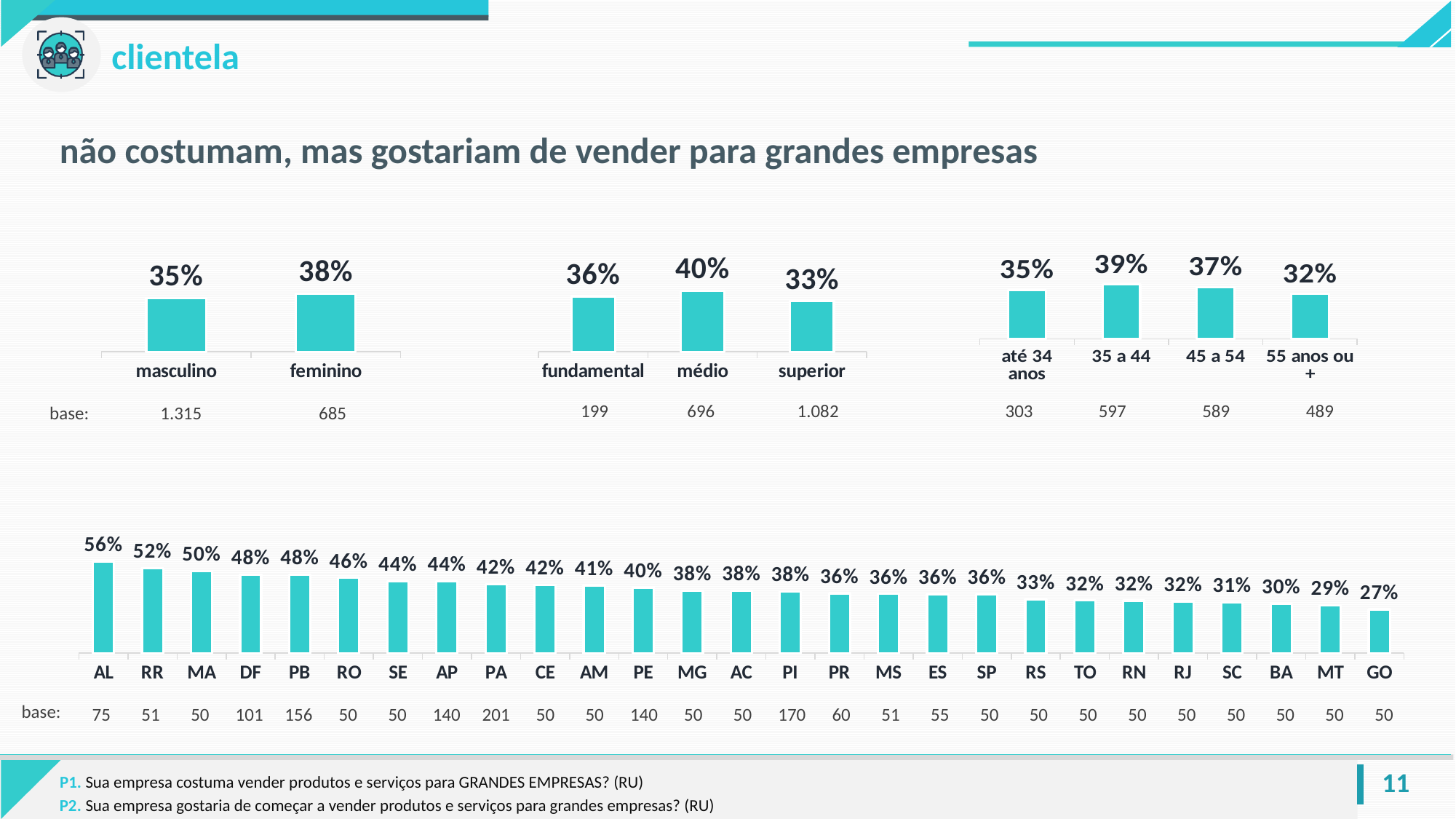
In the top-right chart (age groups), how many age groups are shown? 4 In the top-right chart (age groups), which age group has the highest value? 35 a 44 In the top-middle chart (education levels), what is the value for médio? 40% In the top-middle chart (education levels), what is the difference between médio and superior? 7% In the top-middle chart (education levels), which category has the lowest value? superior In the top-left chart (masculino/feminino), what is the value for feminino? 38% What type of chart is the bottom chart (states)? bar chart In the top-right chart (age groups), what is the value for 55 anos ou +? 32% In the bottom chart (states), what is the difference between AL and GO? 29% In the top-left chart (masculino/feminino), which category has the higher value? feminino In the bottom chart (states), which state has the highest value? AL In the bottom chart (states), which state has the lowest value? GO